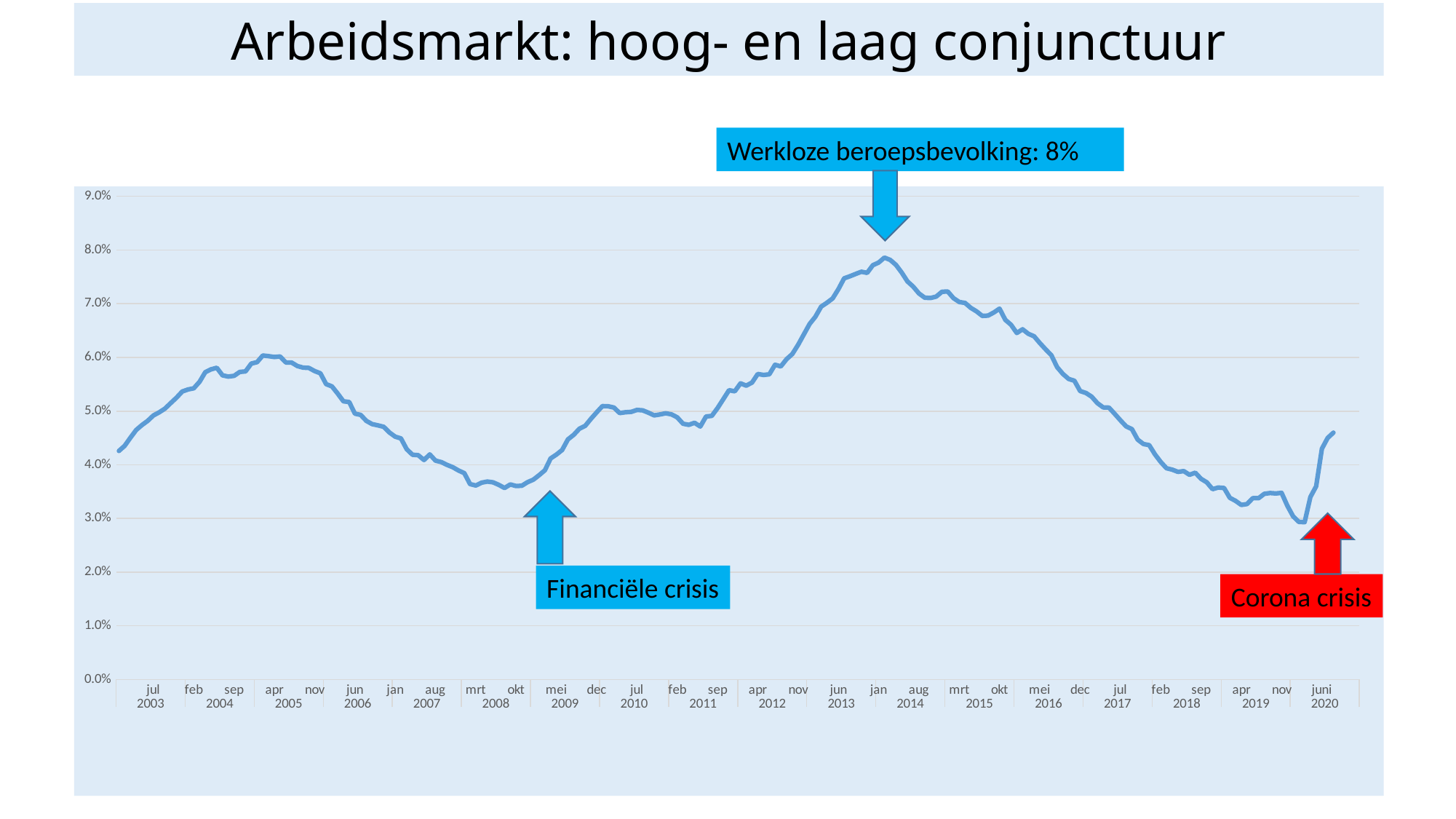
What is the title of the slide? Arbeidsmarkt: hoog- en laag conjunctuur Which event is labelled in the red box at the right end of the chart? Corona crisis What value does the annotation at the peak of the line give for the werkloze beroepsbevolking? 8% Is the value for mrt 2008 greater or less than 4.0%? less Is the value for apr 2019 greater or less than 4.0%? less What kind of chart is shown on the slide? line chart Does the line rise or fall between nov 2019 and juni 2020? rise Is the value for jul 2003 greater or less than 4.0%? greater Does the line rise or fall between jan 2014 and nov 2019? fall